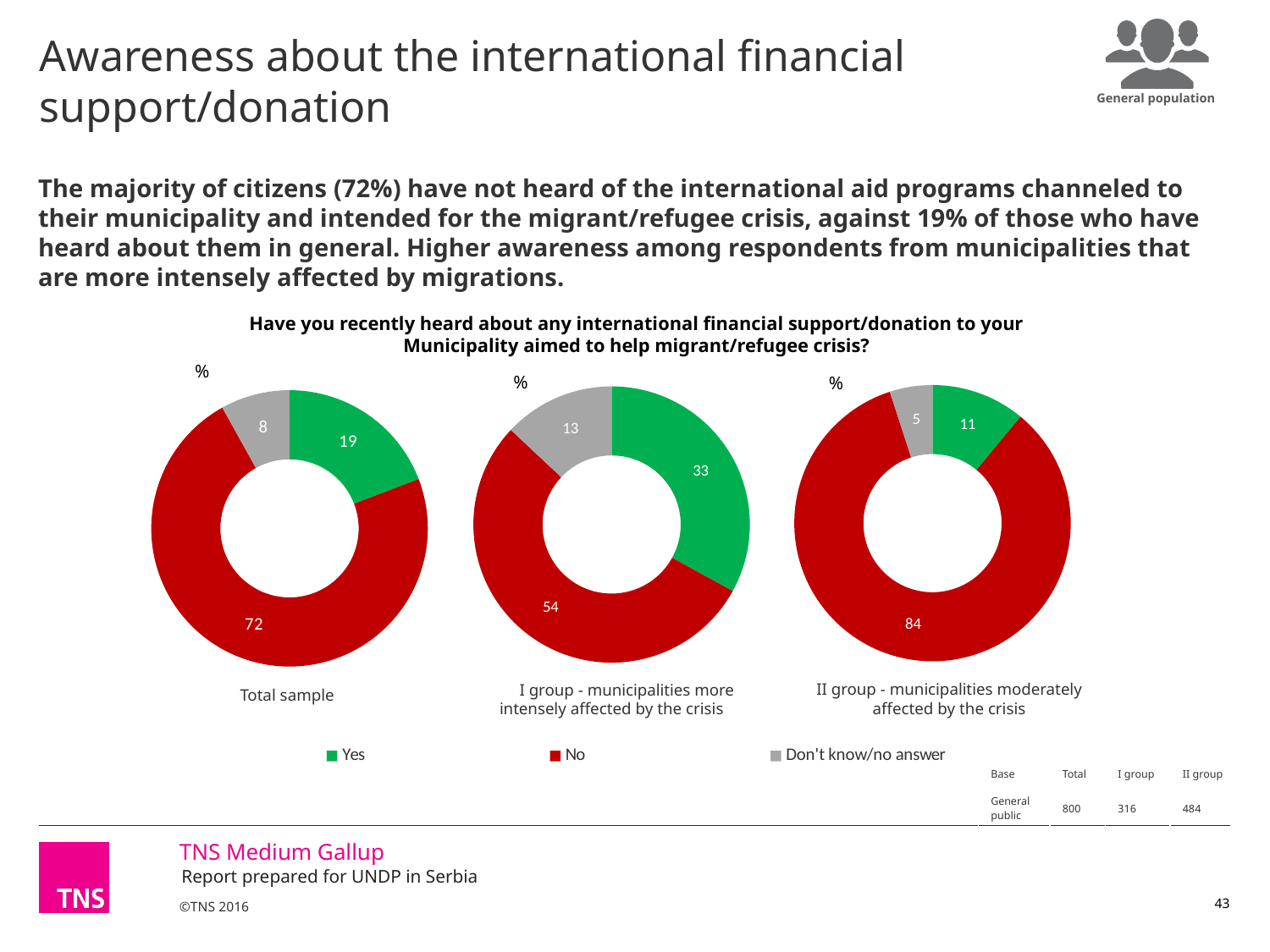
How many doughnut charts are shown on the slide? 3 In the 'Total sample' chart, which response has the largest share? No Which colour represents 'No' in the charts? Red In the 'Total sample' chart, what percentage answered 'No'? 72 In the 'II group - municipalities moderately affected by the crisis' chart, what percentage answered 'Don't know/no answer'? 5 Is the 'Yes' share larger in the 'I group' chart or in the 'II group' chart? I group In the 'I group - municipalities more intensely affected by the crisis' chart, what percentage answered 'Yes'? 33 In the 'Total sample' chart, what is the difference between the 'Yes' and 'Don't know/no answer' shares? 11 In the 'II group - municipalities moderately affected by the crisis' chart, what is the difference between the 'No' and 'Yes' shares? 73 What type of chart is used on this slide? Doughnut chart In the 'I group - municipalities more intensely affected by the crisis' chart, which response has the smallest share? Don't know/no answer How many series does the legend list? 3